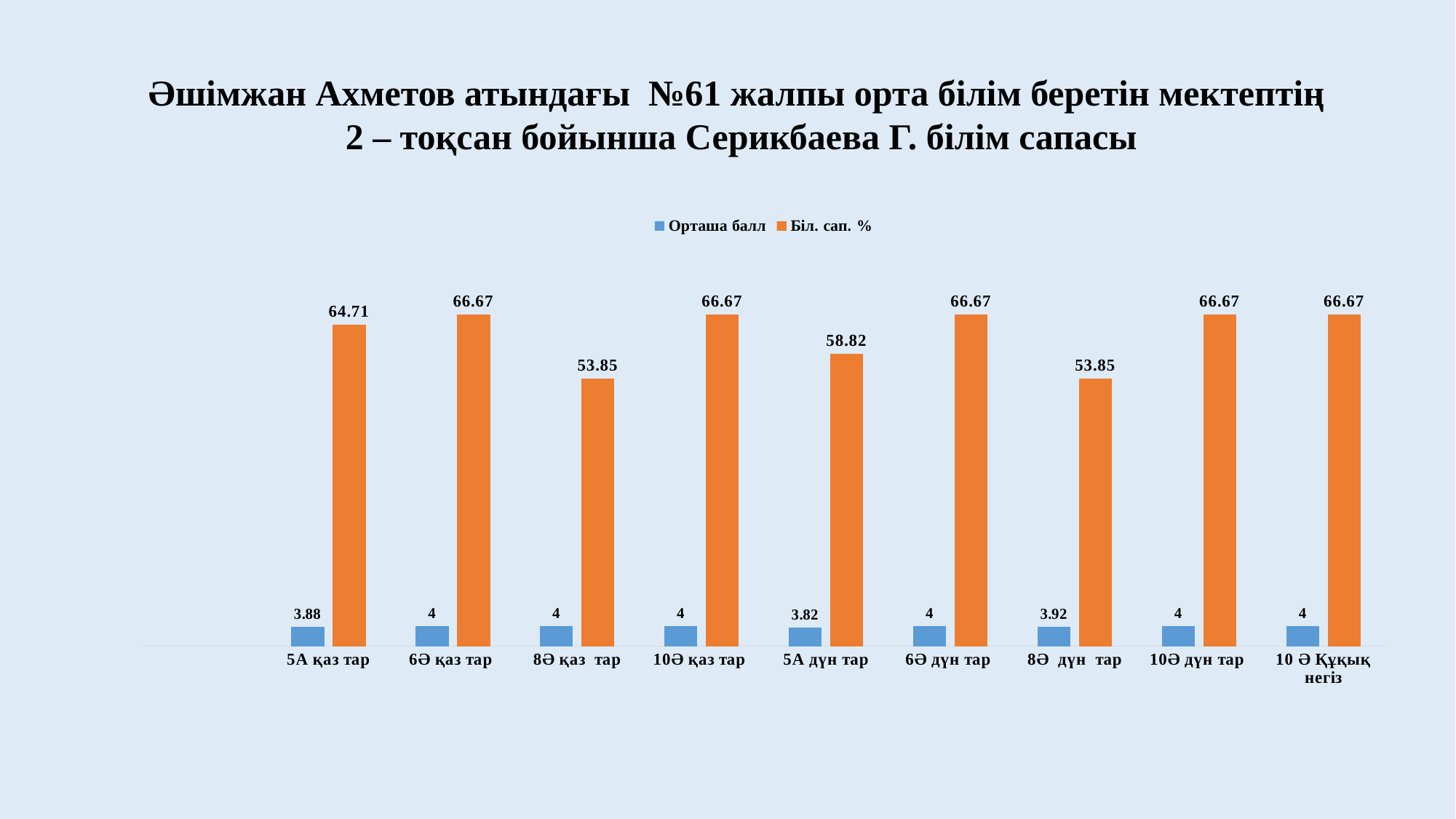
What is the difference between the Біл. сап. % values for 5А қаз тар and 5А дүн тар? 5.89 Which is larger, the Біл. сап. % value for 5А қаз тар or for 5А дүн тар? 5А қаз тар What is the difference between the Біл. сап. % values for 6Ә қаз тар and 8Ә қаз тар? 12.82 Which category has the lowest Орташа балл value? 5А дүн тар What is the Орташа балл value for 8Ә дүн тар? 3.92 What kind of chart is shown on the slide? Bar chart How many categories are shown on the x axis? 9 Which colour represents the Біл. сап. % series? Orange What is the Біл. сап. % value for 5А қаз тар? 64.71 What is the Орташа балл value for 5А дүн тар? 3.82 How many series does the legend list? 2 What is the Біл. сап. % value for 5А дүн тар? 58.82